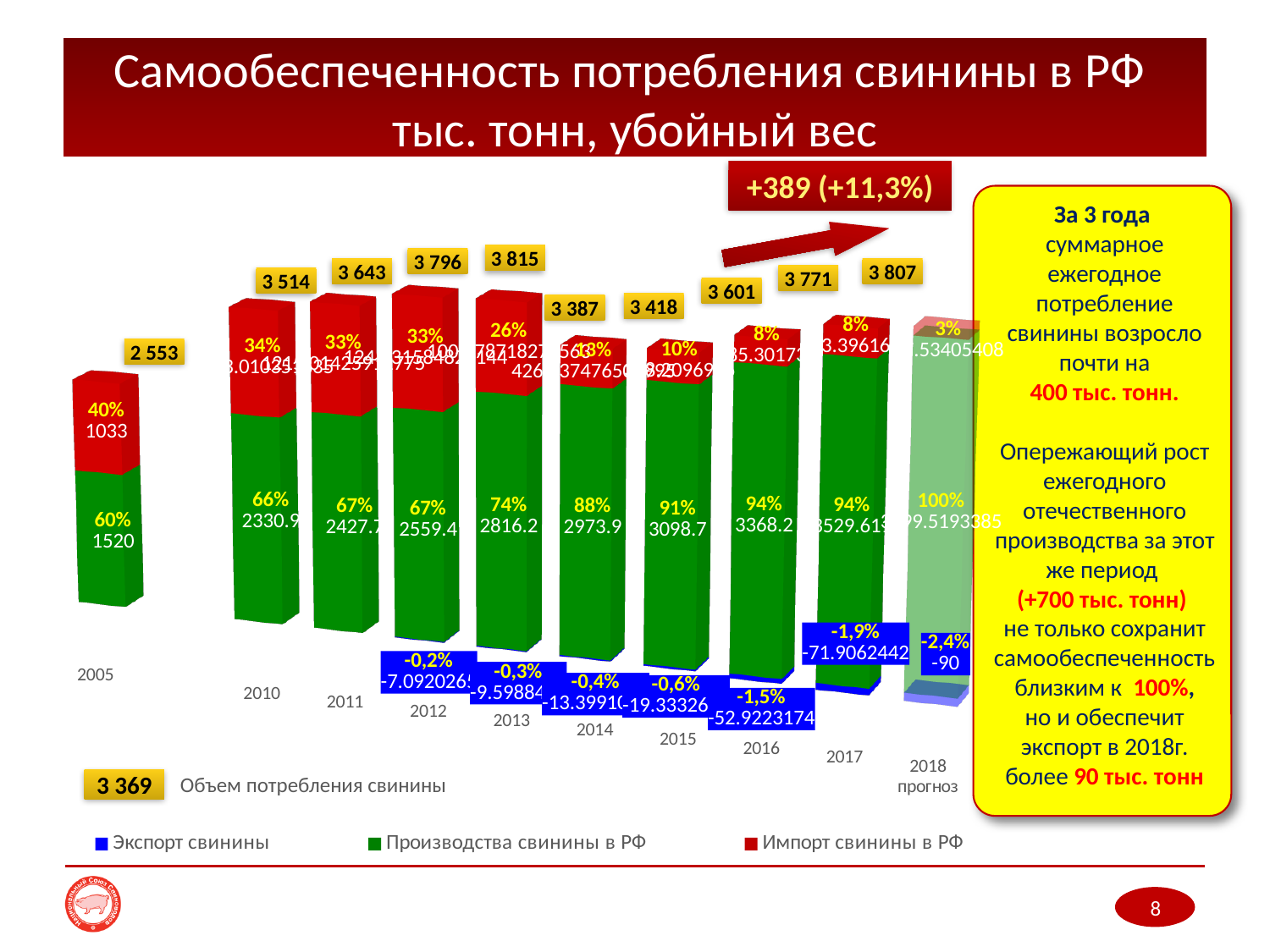
Which year has the lowest total pork consumption volume? 2005 What is the value of pork imports (Импорт свинины в РФ) for 2005? 1033 What is the pork export value shown for the 2018 forecast? -90 What is the total pork consumption volume shown for 2013? 3 815 How many years (categories) are shown along the x axis? 10 Which year has the larger pork production value, 2014 or 2015? 2015 What kind of chart is shown on the slide? Stacked bar chart Does domestic pork production rise or fall from 2010 to 2018? Rises What percentage share does domestic pork production have in 2014? 88% How many series does the legend list? 3 What is the value of pork production in Russia (Производства свинины в РФ) for 2005? 1520 What is the difference between the total pork consumption in 2017 (3 771) and in 2016 (3 601)? 170